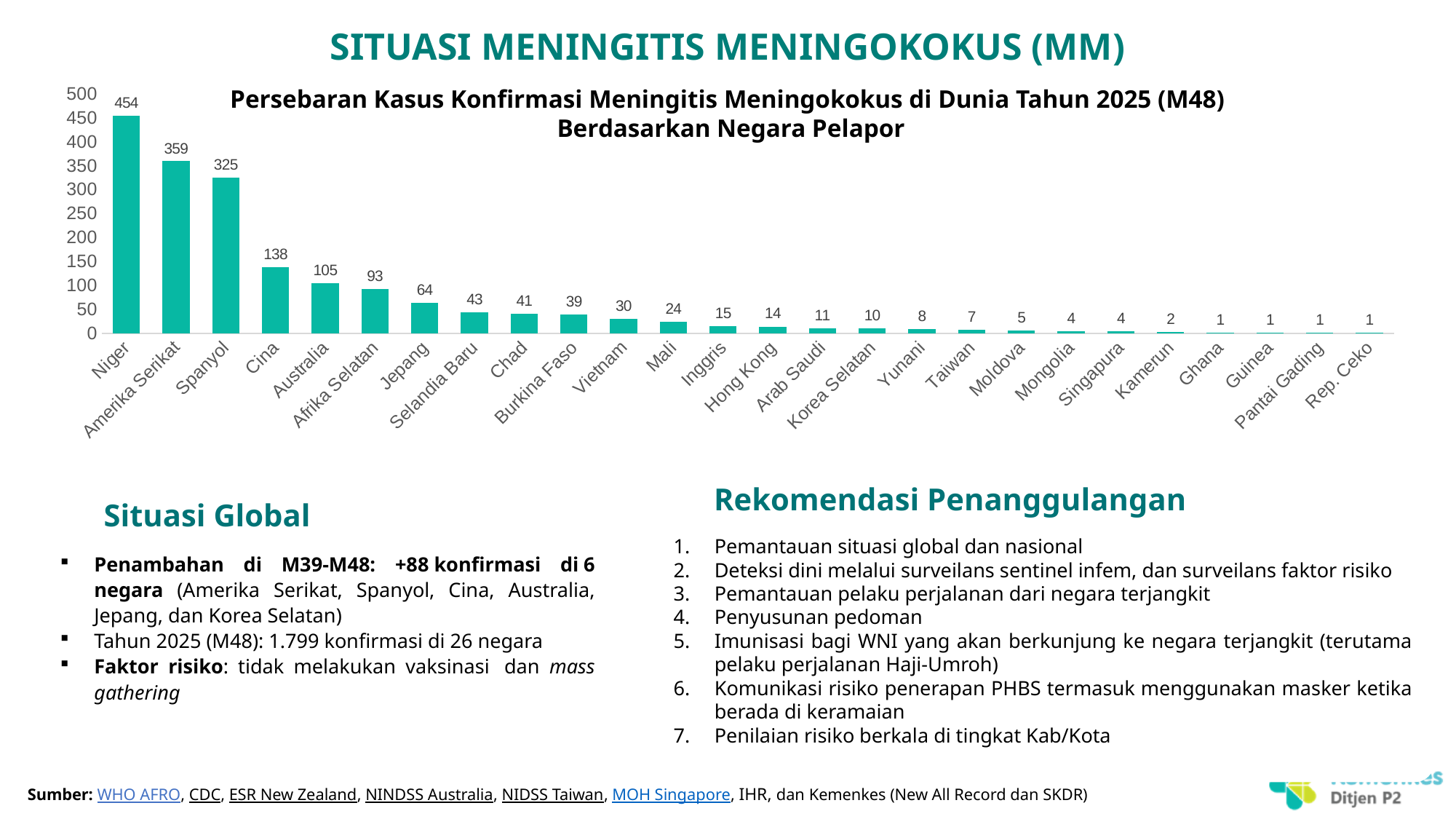
What is the value for Niger? 454 What kind of chart is shown on the slide? Bar chart Is the value for Jepang greater or less than 50? greater What is the difference between the values for Amerika Serikat and Spanyol? 34 How many countries are shown on the x axis? 26 What is the value for Korea Selatan? 10 Which is larger, the value for Australia or the value for Afrika Selatan? Australia What colour are the bars in the chart? Teal (green) What is the value for Cina? 138 What is the value for Selandia Baru? 43 Which country has the highest number of confirmed cases? Niger Do the values rise or fall from left to right along the x axis? Fall